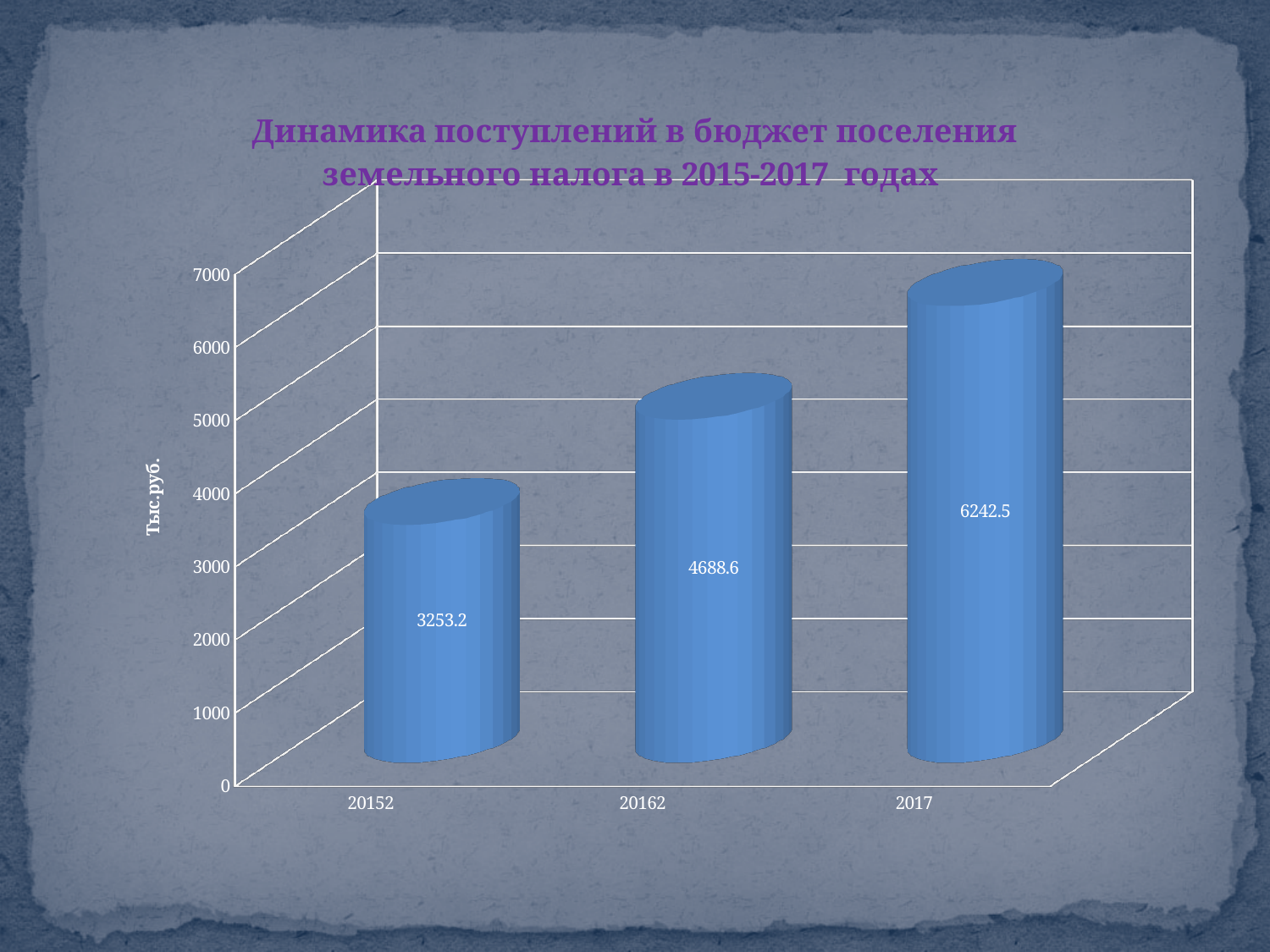
Which is larger, the value for 20162 or the value for 2017? 2017 What kind of chart is shown on the slide? Bar chart How many categories are shown on the x axis? 3 What is the value for the category labelled 20162? 4688.6 Which category has the lowest value? 20152 What is the label of the vertical axis? Тыс.руб. What is the difference between the values for 20162 and 20152? 1435.4 What is the difference between the values for 2017 and 20162? 1553.9 What is the value for the category labelled 20152? 3253.2 What is the value for 2017? 6242.5 Do the values rise or fall from left to right along the x axis? Rise Which category has the highest value? 2017